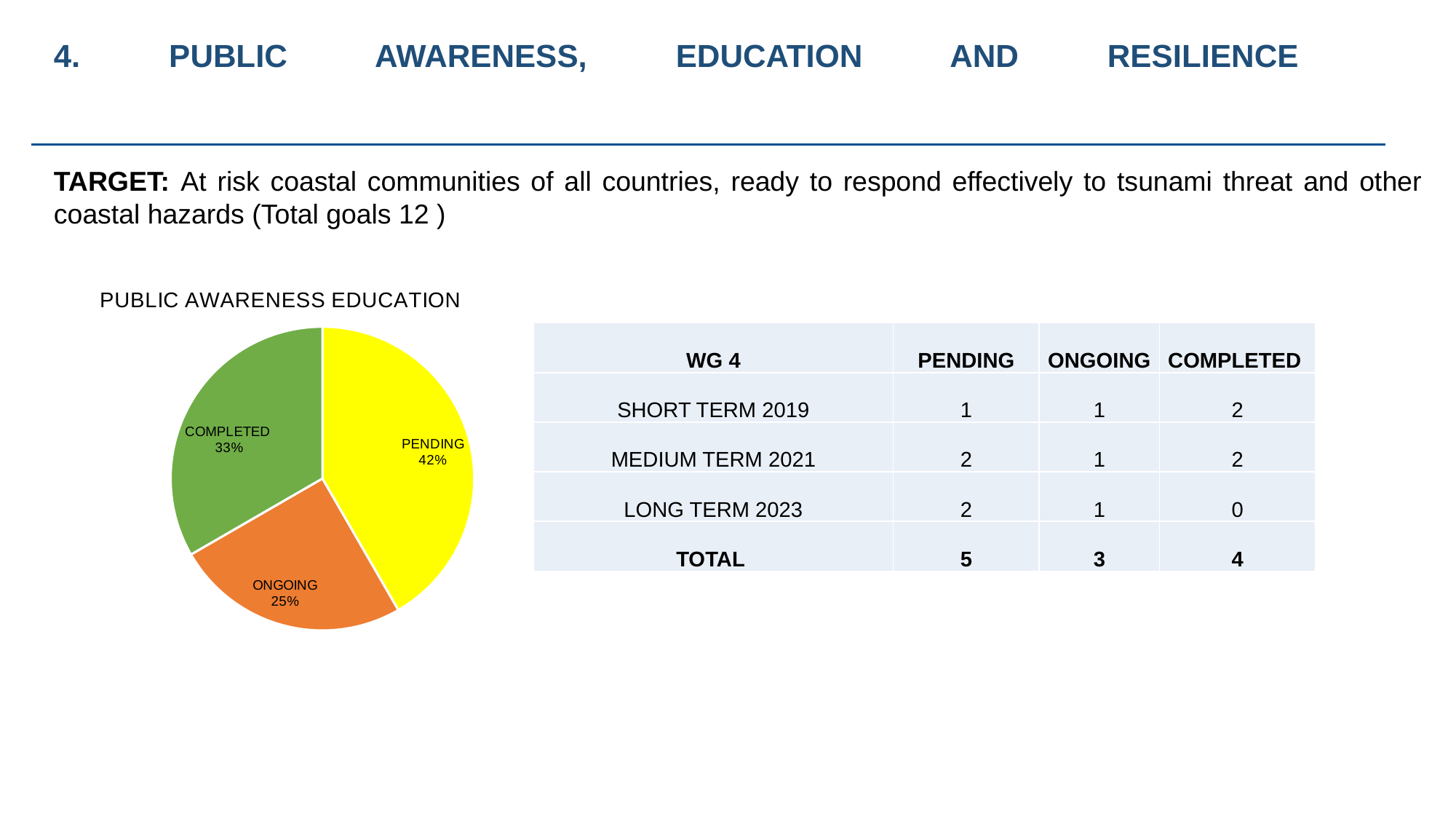
How many slices does the pie chart have? 3 What share of the pie chart is PENDING? 42% What colour is the PENDING slice of the pie chart? yellow Which is larger in the pie chart, COMPLETED or ONGOING? COMPLETED What is the difference in percentage points between the COMPLETED and ONGOING slices? 8% Which slice of the pie chart is the smallest? ONGOING What type of chart is shown on the slide? pie chart What share of the pie chart is ONGOING? 25% Which slice of the pie chart is the largest? PENDING What share of the pie chart is COMPLETED? 33% What is the title of the pie chart? PUBLIC AWARENESS EDUCATION What is the difference in percentage points between the PENDING and ONGOING slices? 17%